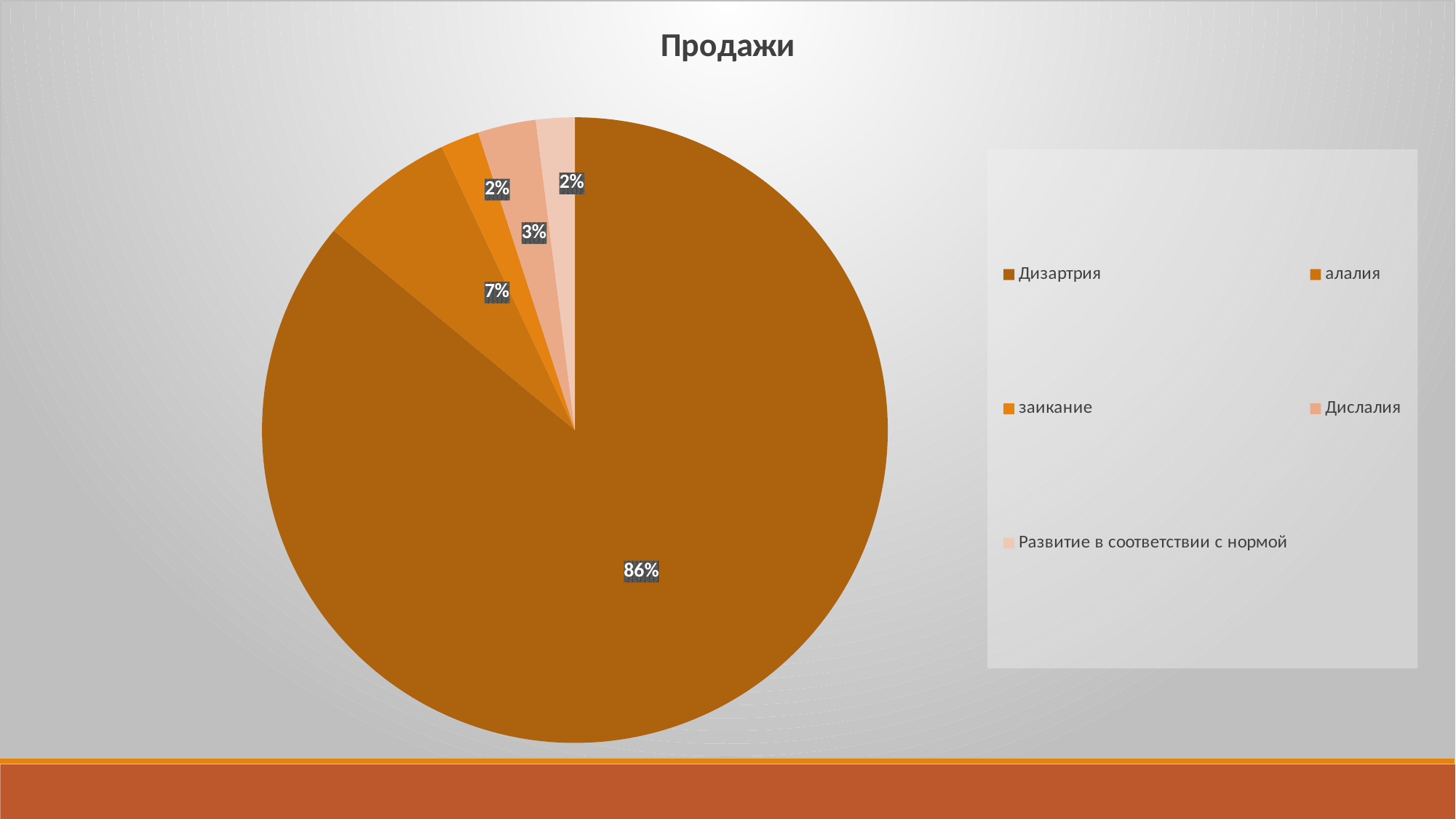
What is the title of the chart? Продажи What is the value shown for Дислалия? 3% What is the difference between the shares of Дислалия and заикание? 1% Which is larger, the share for алалия or the share for Дислалия? алалия What is the value shown for заикание? 2% What is the value shown for алалия? 7% Which category has the largest slice of the pie? Дизартрия How many categories does the legend list? 5 What is the difference between the shares of Дизартрия and алалия? 79% What is the value shown for Развитие в соответствии с нормой? 2% What share of the pie does Дизартрия take? 86% What type of chart is shown on the slide? pie chart